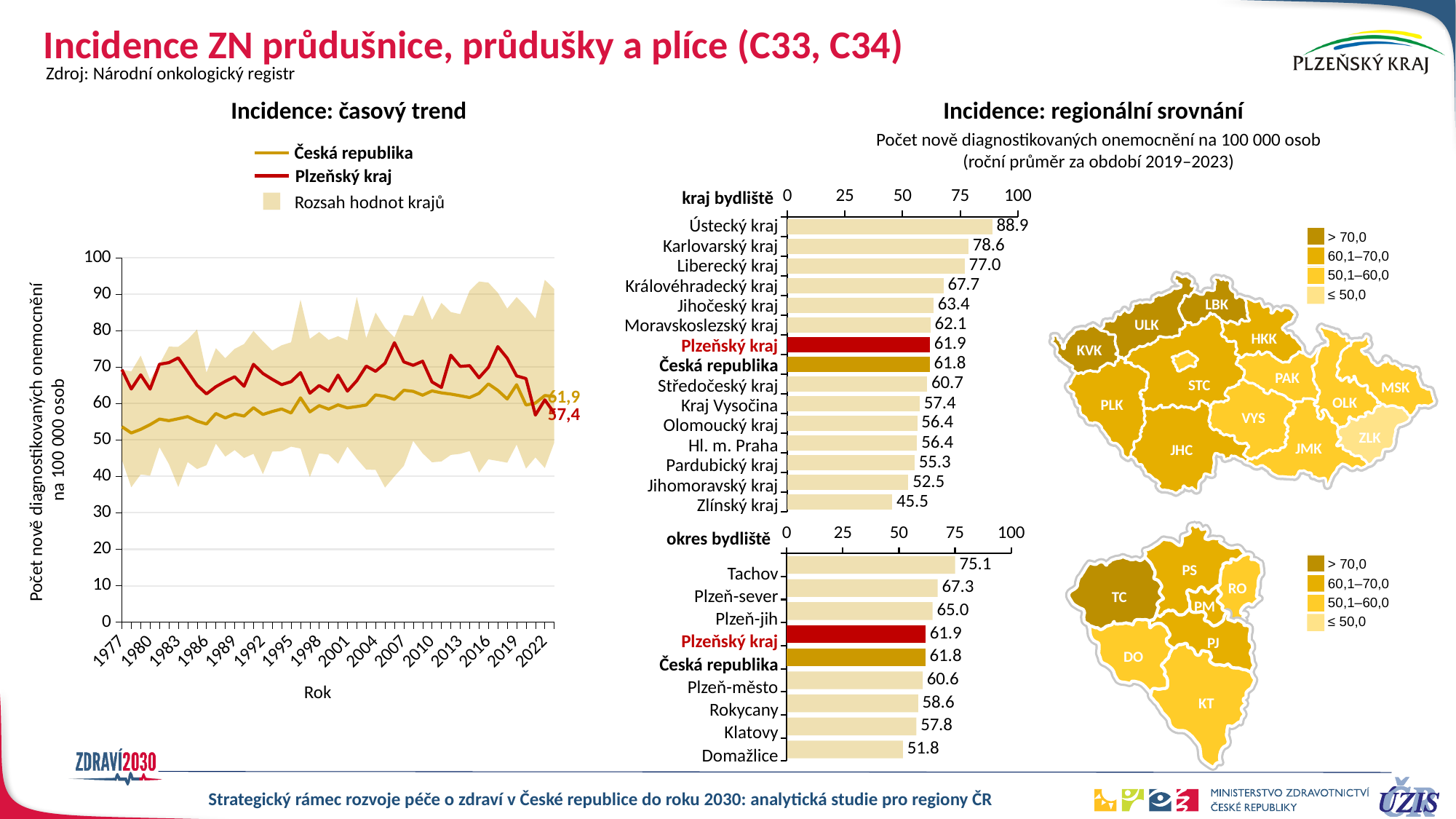
In the 'okres bydliště' bar chart, what is the value for Tachov? 75.1 In the 'kraj bydliště' bar chart, what is the value for Plzeňský kraj? 61.9 In the 'okres bydliště' bar chart, which district has the lowest value? Domažlice In the 'kraj bydliště' bar chart, what is the difference between the values for Ústecký kraj and Zlínský kraj? 43.4 In the 'kraj bydliště' bar chart, which is larger, the value for Jihočeský kraj or for Moravskoslezský kraj? Jihočeský kraj In the 'kraj bydliště' bar chart, which region has the highest value? Ústecký kraj What kind of chart is 'Incidence: časový trend'? line chart In the 'okres bydliště' bar chart, how many bars are shown? 9 In the 'Incidence: časový trend' chart, what is the last labelled value for Plzeňský kraj? 57,4 In the 'kraj bydliště' bar chart, what is the value for Ústecký kraj? 88.9 In the 'okres bydliště' bar chart, what is the difference between the values for Tachov and Domažlice? 23.3 In the 'kraj bydliště' bar chart, which region has the lowest value? Zlínský kraj